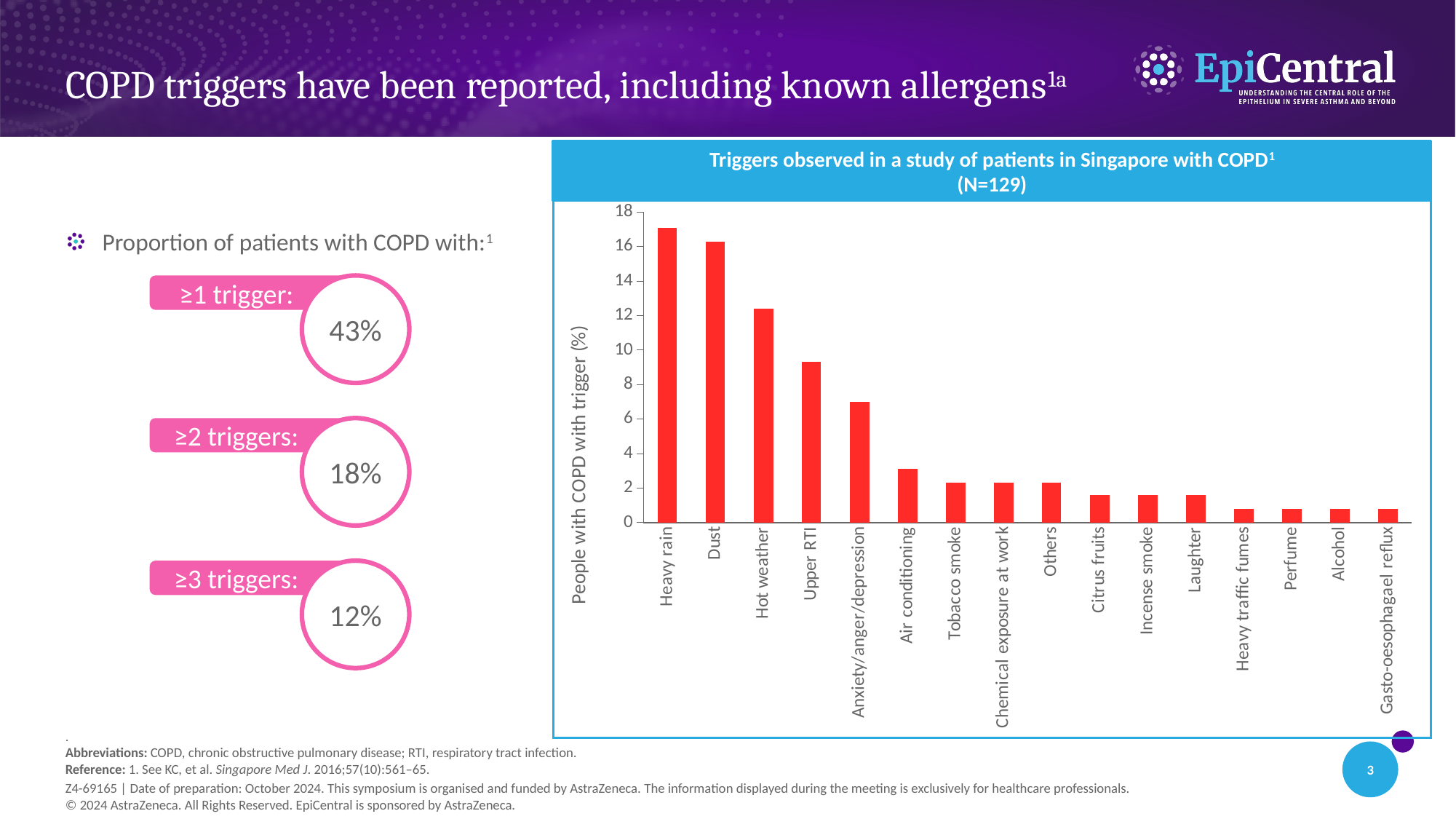
Do the bar values rise or fall moving from left to right along the x axis? Fall Is the value for Hot weather greater or less than 10? greater Is the value for Citrus fruits greater or less than 2? less What kind of chart is shown on the slide? Bar chart Which has a higher value, Dust or Hot weather? Dust Which trigger has the highest percentage of people with COPD in the chart? Heavy rain How many trigger categories are plotted on the x axis of the chart? 16 Is the value for Dust greater or less than 14? greater What is the label of the chart's y axis? People with COPD with trigger (%) Which has a higher value, Upper RTI or Anxiety/anger/depression? Upper RTI